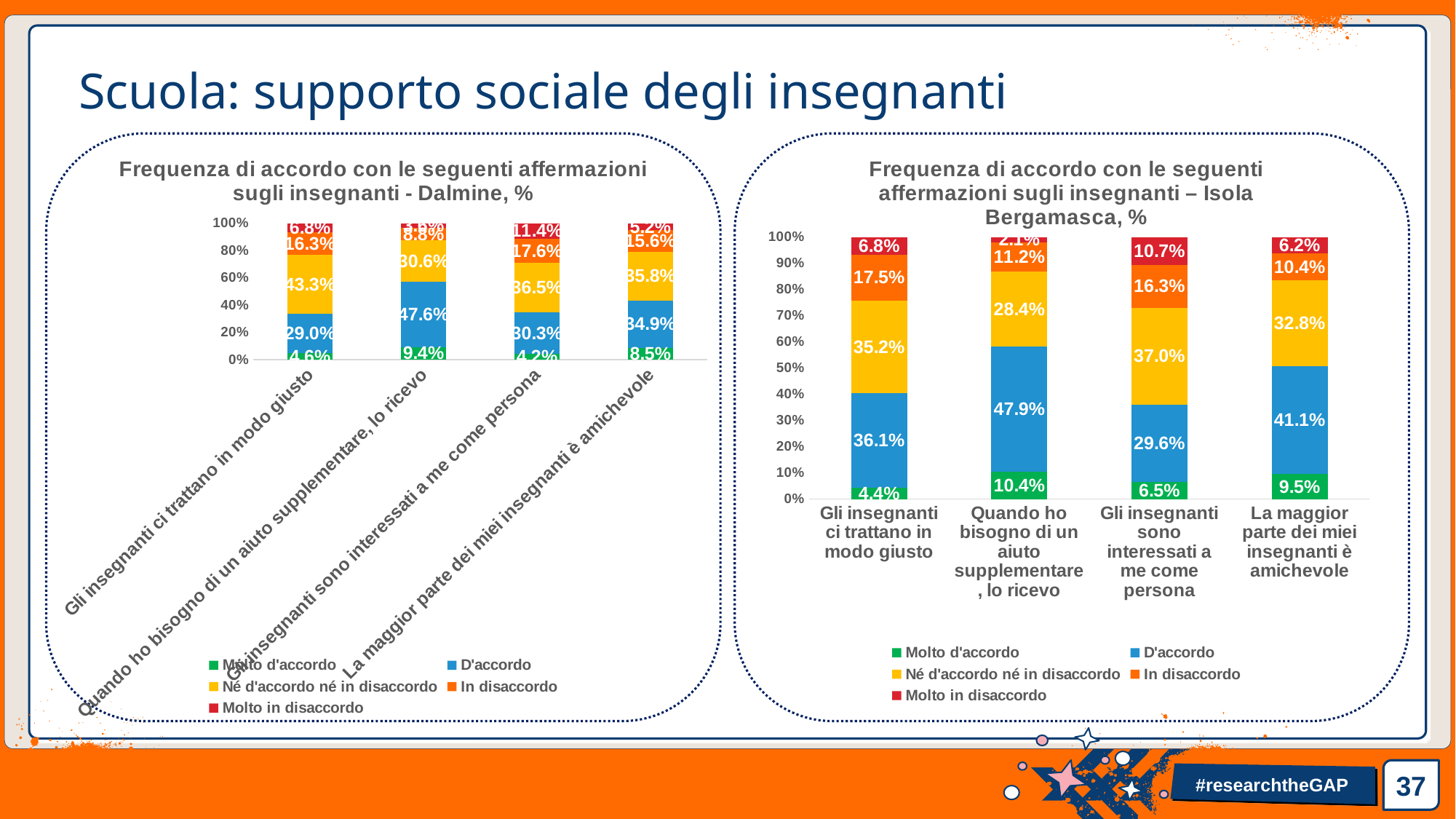
What kind of chart is the Isola Bergamasca chart? Stacked bar chart In the Isola Bergamasca chart, which statement has the lowest 'D'accordo' value? Gli insegnanti sono interessati a me come persona In the Isola Bergamasca chart, what is the difference between the 'D'accordo' values for 'La maggior parte dei miei insegnanti è amichevole' and 'Gli insegnanti ci trattano in modo giusto'? 5.0% In the Isola Bergamasca chart, which statement has the highest 'Molto d'accordo' value? Quando ho bisogno di un aiuto supplementare, lo ricevo In the Isola Bergamasca chart, what is the 'Molto in disaccordo' value for 'Gli insegnanti sono interessati a me come persona'? 10.7% In the Dalmine chart, which is larger: the 'D'accordo' value for 'Gli insegnanti ci trattano in modo giusto' or for 'Gli insegnanti sono interessati a me come persona'? Gli insegnanti sono interessati a me come persona In the Dalmine chart, what is the 'Molto d'accordo' value for 'La maggior parte dei miei insegnanti è amichevole'? 8.5% How many statements (categories) are shown in the Isola Bergamasca chart? 4 In the Isola Bergamasca chart, what is the 'D'accordo' value for 'Quando ho bisogno di un aiuto supplementare, lo ricevo'? 47.9% In the Dalmine chart, what is the 'Né d'accordo né in disaccordo' value for 'Gli insegnanti ci trattano in modo giusto'? 43.3% In the Isola Bergamasca chart, which colour represents 'Né d'accordo né in disaccordo'? Yellow How many series does the legend of the Dalmine chart list? 5